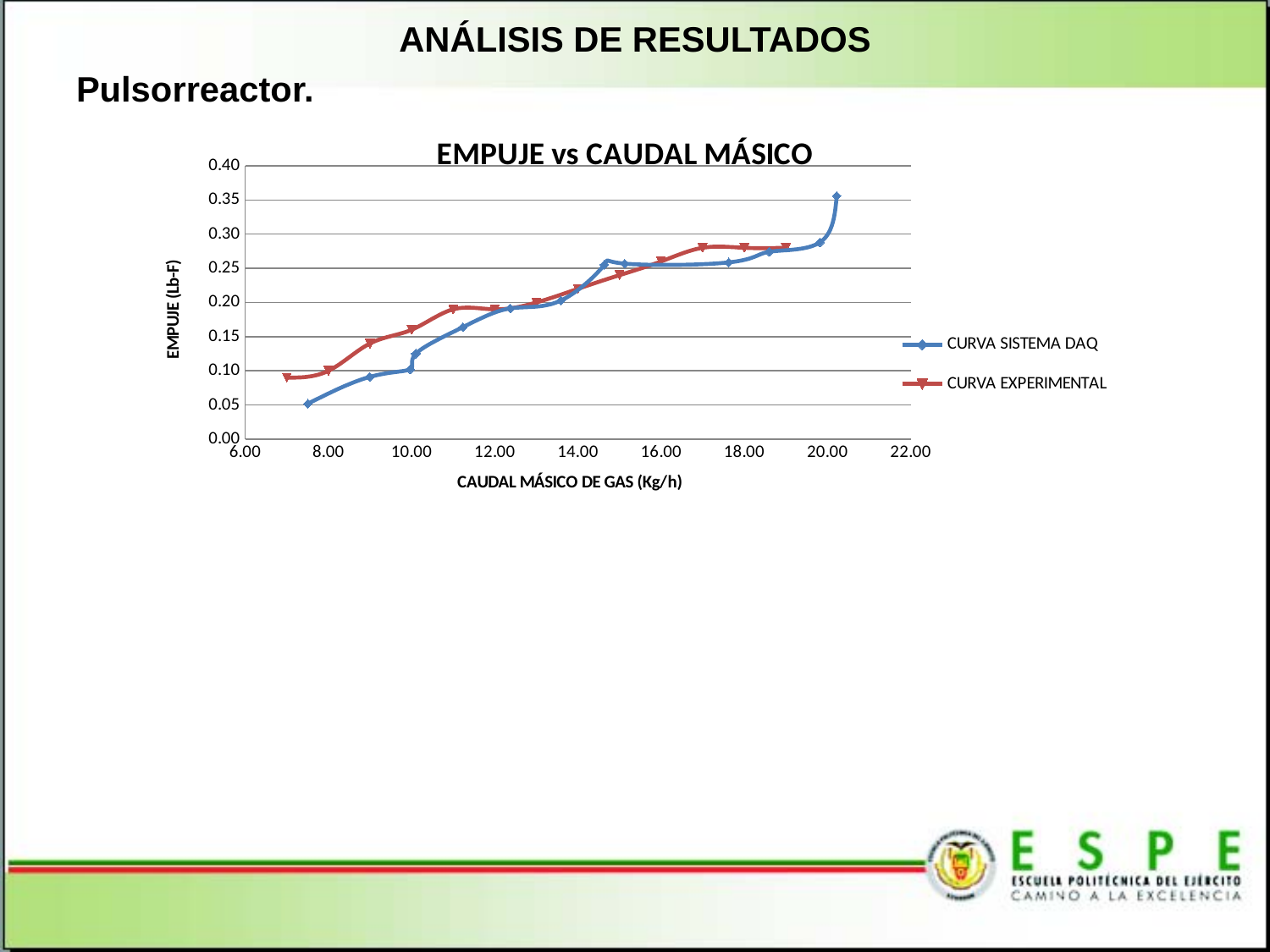
Is the highest value of CURVA EXPERIMENTAL greater or less than 0.30? less How many series does the legend of the chart list? 2 Is the value of CURVA EXPERIMENTAL at about 17.00 Kg/h greater or less than 0.25? greater What is the label of the x axis of the chart? CAUDAL MÁSICO DE GAS (Kg/h) Is the highest value of CURVA SISTEMA DAQ greater or less than 0.30? greater What is the title of the chart? EMPUJE vs CAUDAL MÁSICO At about 9.00 Kg/h, which series has the higher empuje value, CURVA SISTEMA DAQ or CURVA EXPERIMENTAL? CURVA EXPERIMENTAL Which series reaches the highest empuje value on the chart? CURVA SISTEMA DAQ Do the values of CURVA SISTEMA DAQ generally rise or fall as the caudal másico increases? rise Do the values of CURVA EXPERIMENTAL generally rise or fall along the x axis? rise What kind of chart is shown on the slide? line chart